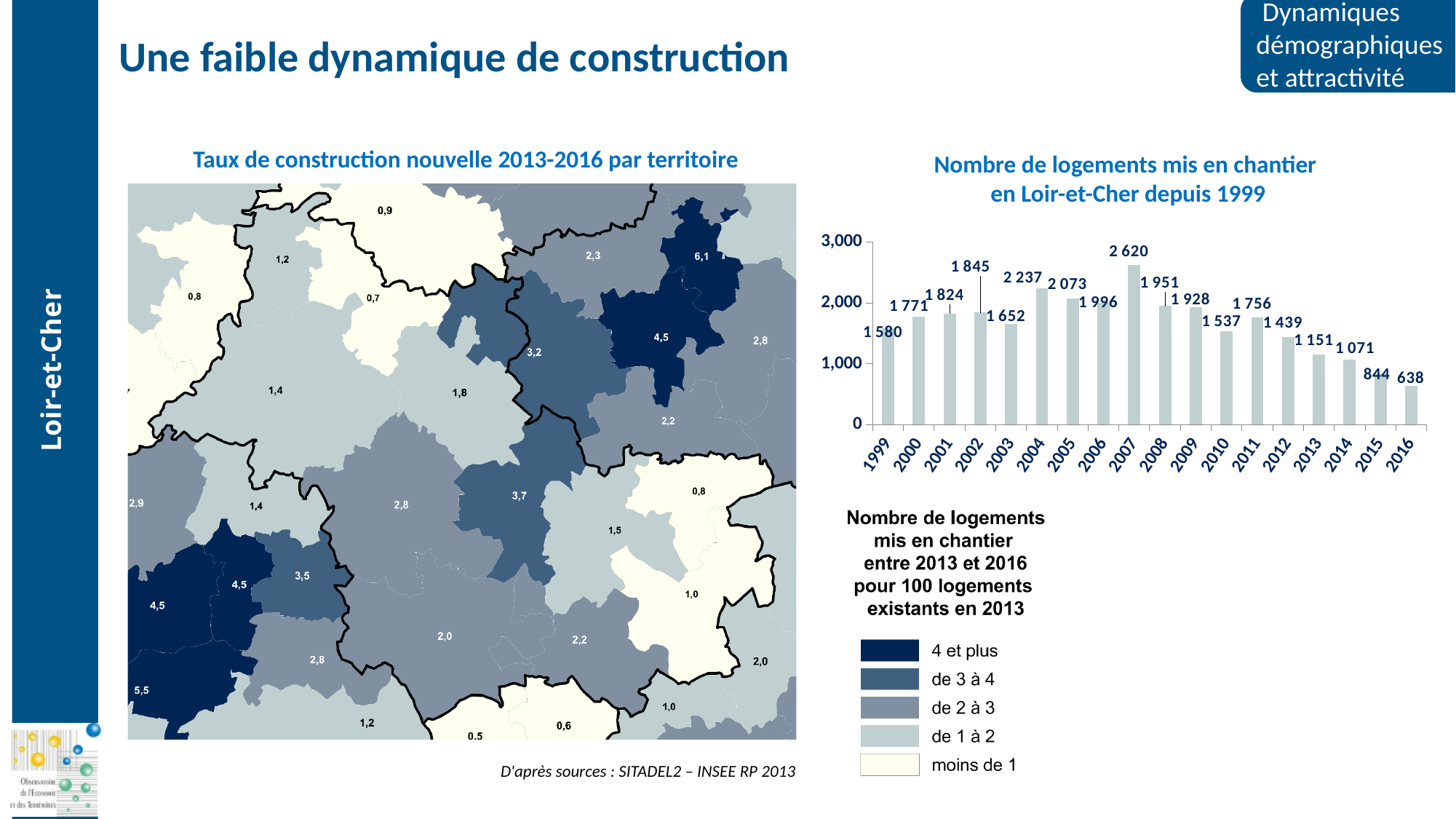
In the bar chart 'Nombre de logements mis en chantier en Loir-et-Cher depuis 1999', which is larger, the value for 2004 or the value for 2005? 2004 In the bar chart 'Nombre de logements mis en chantier en Loir-et-Cher depuis 1999', which year has the lowest value? 2016 In the bar chart 'Nombre de logements mis en chantier en Loir-et-Cher depuis 1999', what is the value for 2016? 638 In the bar chart 'Nombre de logements mis en chantier en Loir-et-Cher depuis 1999', what is the value for 2007? 2 620 What kind of chart is 'Nombre de logements mis en chantier en Loir-et-Cher depuis 1999'? bar chart In the bar chart 'Nombre de logements mis en chantier en Loir-et-Cher depuis 1999', what is the difference between the values for 2007 and 2016? 1 982 In the bar chart 'Nombre de logements mis en chantier en Loir-et-Cher depuis 1999', which year has the highest value? 2007 In the bar chart 'Nombre de logements mis en chantier en Loir-et-Cher depuis 1999', how many years are shown on the x axis? 18 In the bar chart 'Nombre de logements mis en chantier en Loir-et-Cher depuis 1999', do the values rise or fall from 2012 to 2016? fall In the bar chart 'Nombre de logements mis en chantier en Loir-et-Cher depuis 1999', is the value for 2015 greater or less than 1,000? less On the map 'Taux de construction nouvelle 2013-2016 par territoire', how many classes does the legend list? 5 In the bar chart 'Nombre de logements mis en chantier en Loir-et-Cher depuis 1999', what is the value for 1999? 1 580